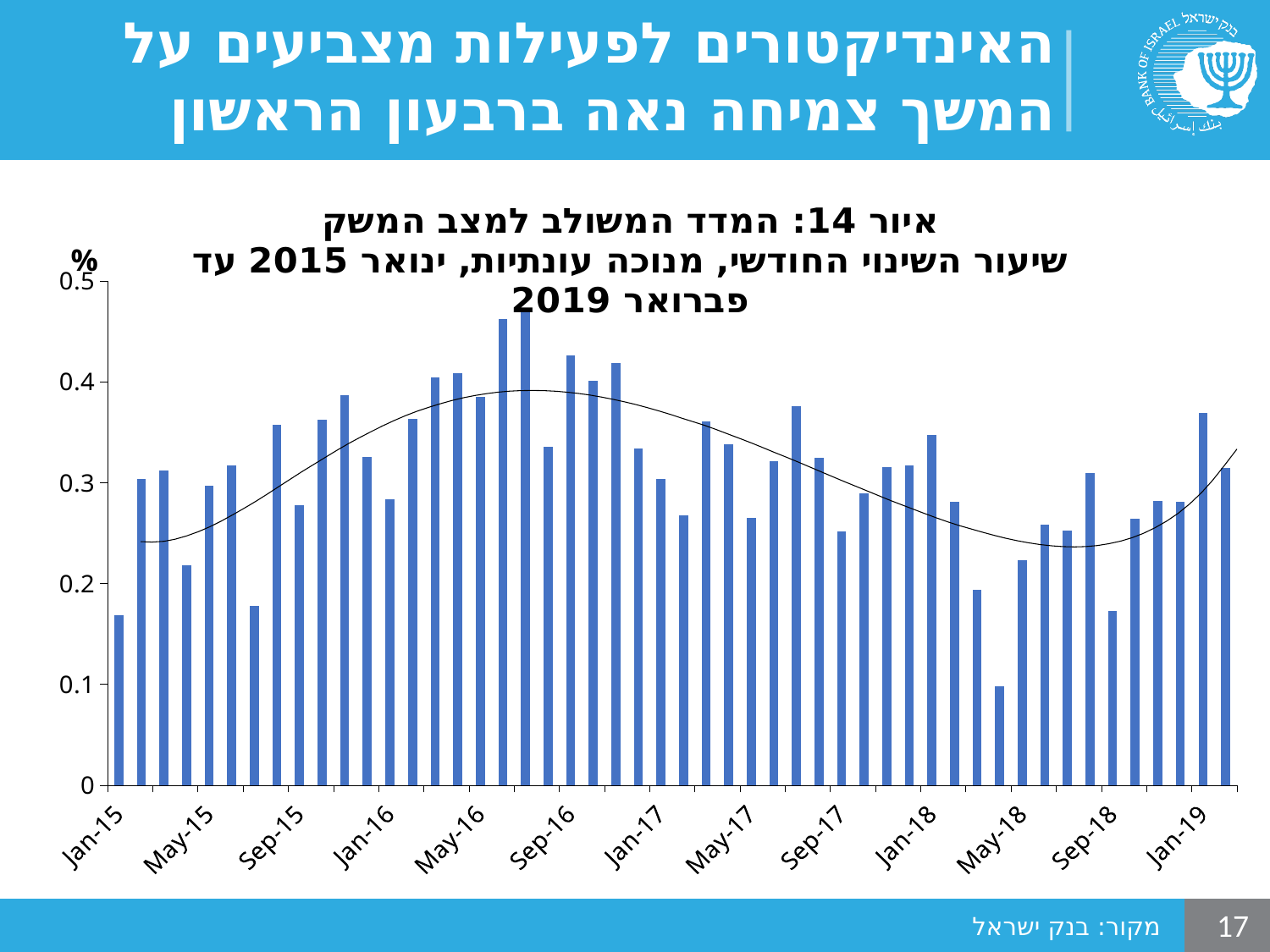
Does the smoothed trend line rise or fall between Sep-16 and Sep-18? falls Is the value for Sep-16 greater or less than 0.4? greater Is the value for Jan-19 greater or less than 0.3? greater Is the value for May-17 greater or less than 0.3? less Which bar is taller, Sep-16 or Sep-18? Sep-16 What kind of chart is shown on the slide? bar chart Which bar is taller, Jan-19 or Jan-16? Jan-19 How many month labels are shown on the x axis? 13 What unit is shown at the top of the y axis? %